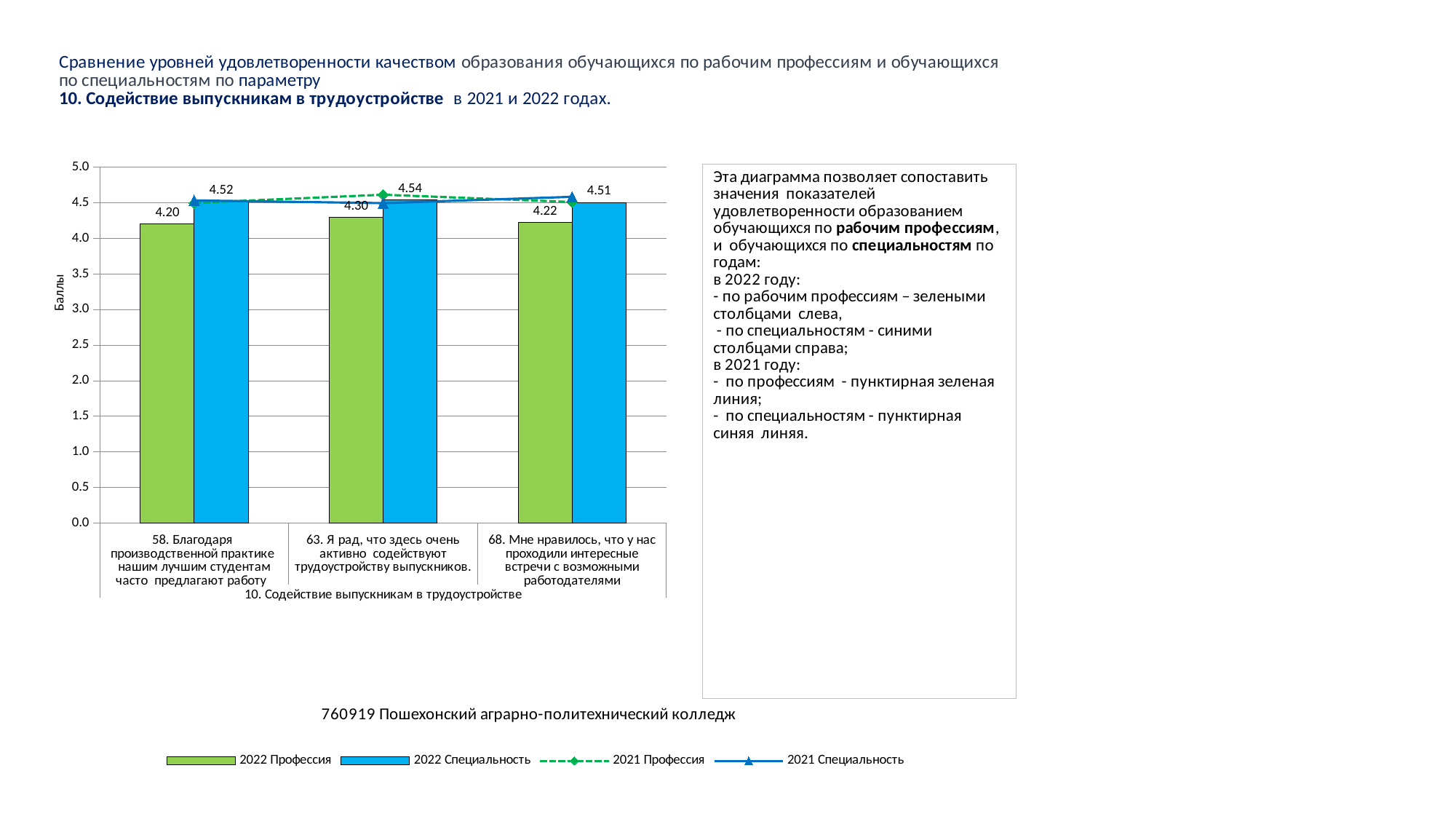
Which category has the lowest 2022 Профессия bar? 58. Благодаря производственной практике нашим лучшим студентам часто предлагают работу What is the value of the 2022 Профессия bar for category 68 (Мне нравилось, что у нас проходили интересные встречи с возможными работодателями)? 4.22 What is the difference between the 2022 Специальность and 2022 Профессия values for category 58? 0.32 For category 63, which is larger: the 2022 Профессия bar or the 2022 Специальность bar? 2022 Специальность What is the value of the 2022 Профессия bar for category 58 (Благодаря производственной практике нашим лучшим студентам часто предлагают работу)? 4.20 How many categories (questions) are shown on the x axis of the chart? 3 How many series does the chart legend list? 4 Is the 2022 Профессия value for category 58 greater or less than 4.5? less What is the label of the vertical axis of the chart? Баллы Which category has the highest 2022 Профессия bar? 63. Я рад, что здесь очень активно содействуют трудоустройству выпускников. What is the value of the 2022 Специальность bar for category 68? 4.51 What is the value of the 2022 Специальность bar for category 63 (Я рад, что здесь очень активно содействуют трудоустройству выпускников)? 4.54